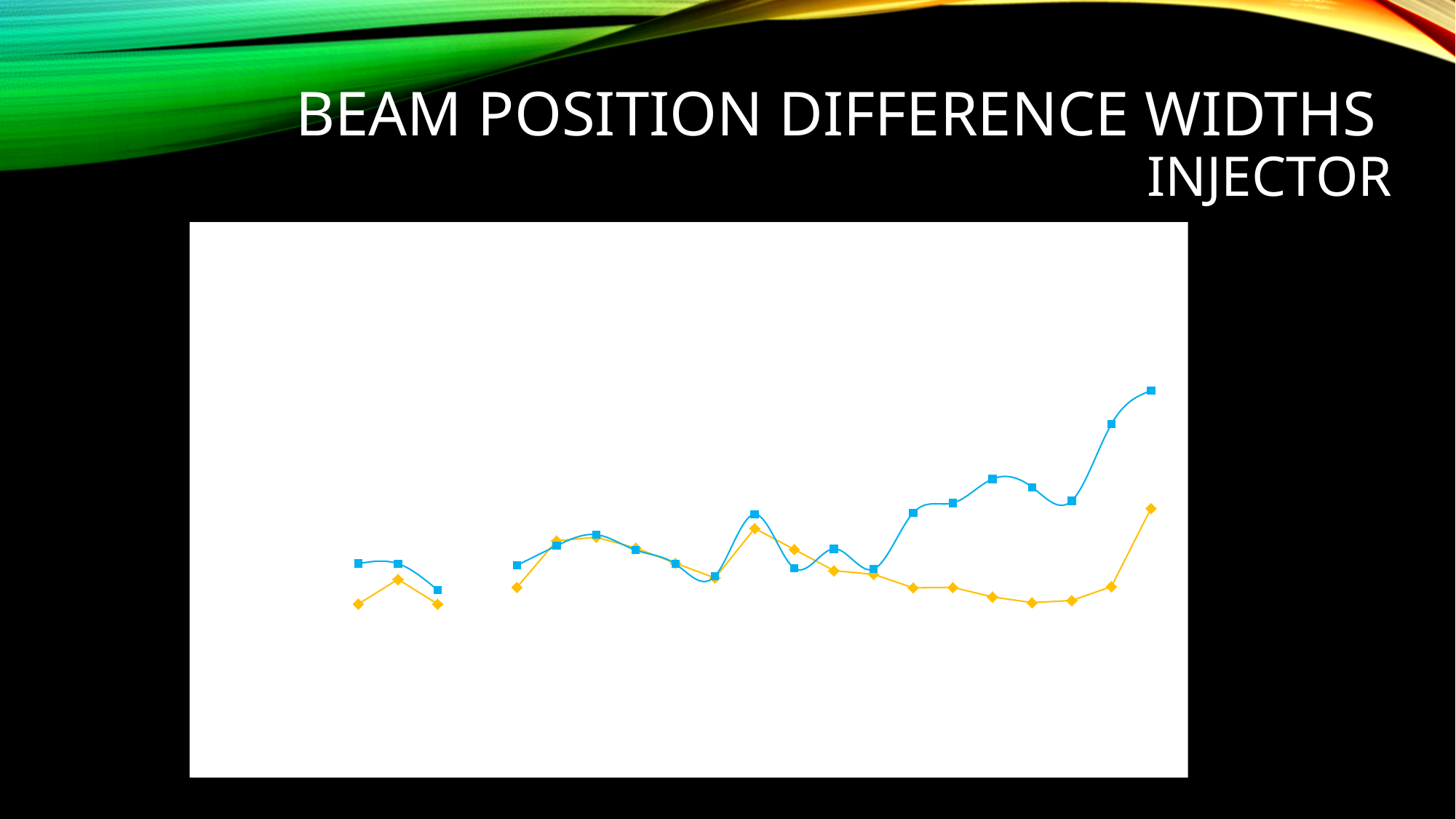
At the rightmost point of the chart, which series is higher, blue or yellow? blue How many data series (lines) are plotted on the chart? 2 What marker shape is used for the blue series? squares Which series reaches the highest point on the chart, the blue one or the yellow one? blue Does the blue line rise or fall over the last few points at the right end of the chart? rise Does the chart show a gap (missing points) between the first group of points and the rest of the data? yes Does the yellow line rise or fall between its last two points at the right end of the chart? rise What kind of chart is shown on the slide? line chart What colours are the two lines on the chart? blue and yellow